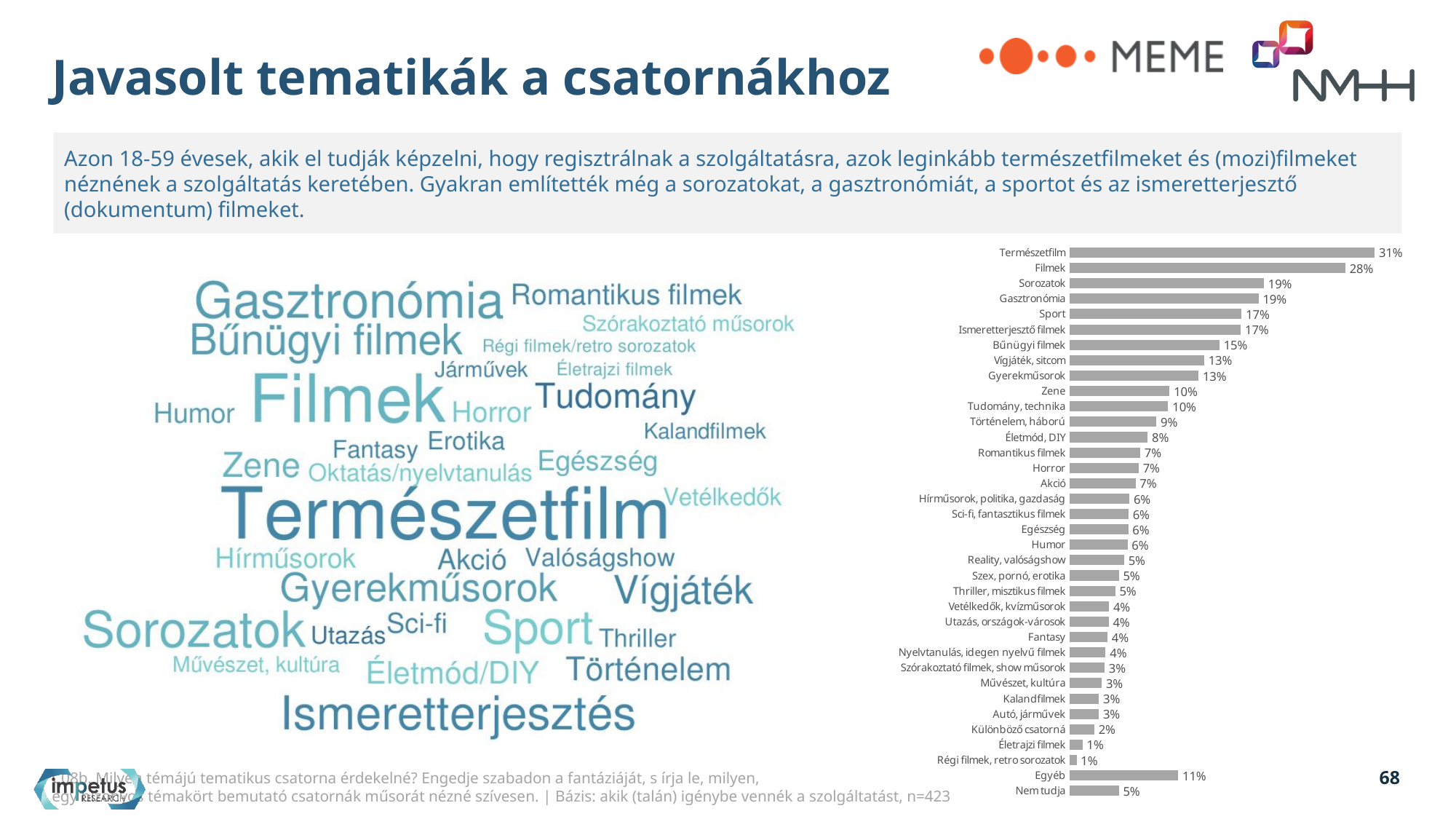
In the bar chart, what is the value for Gasztronómia? 19% In the bar chart, which is larger, Sorozatok or Vígjáték, sitcom? Sorozatok In the bar chart, what is the value for Bűnügyi filmek? 15% In the bar chart, what is the value for Nem tudja? 5% In the bar chart, what is the difference between Természetfilm and Filmek? 3% In the bar chart, what is the difference between Sport and Zene? 7% In the bar chart, which is larger, Egyéb or Életmód, DIY? Egyéb In the bar chart, which category has the highest value? Természetfilm In the bar chart, what is the value for Természetfilm? 31% What kind of chart is shown on the right side of the slide? Bar chart In the bar chart, what is the value for Egyéb? 11% How many categories does the bar chart show? 36